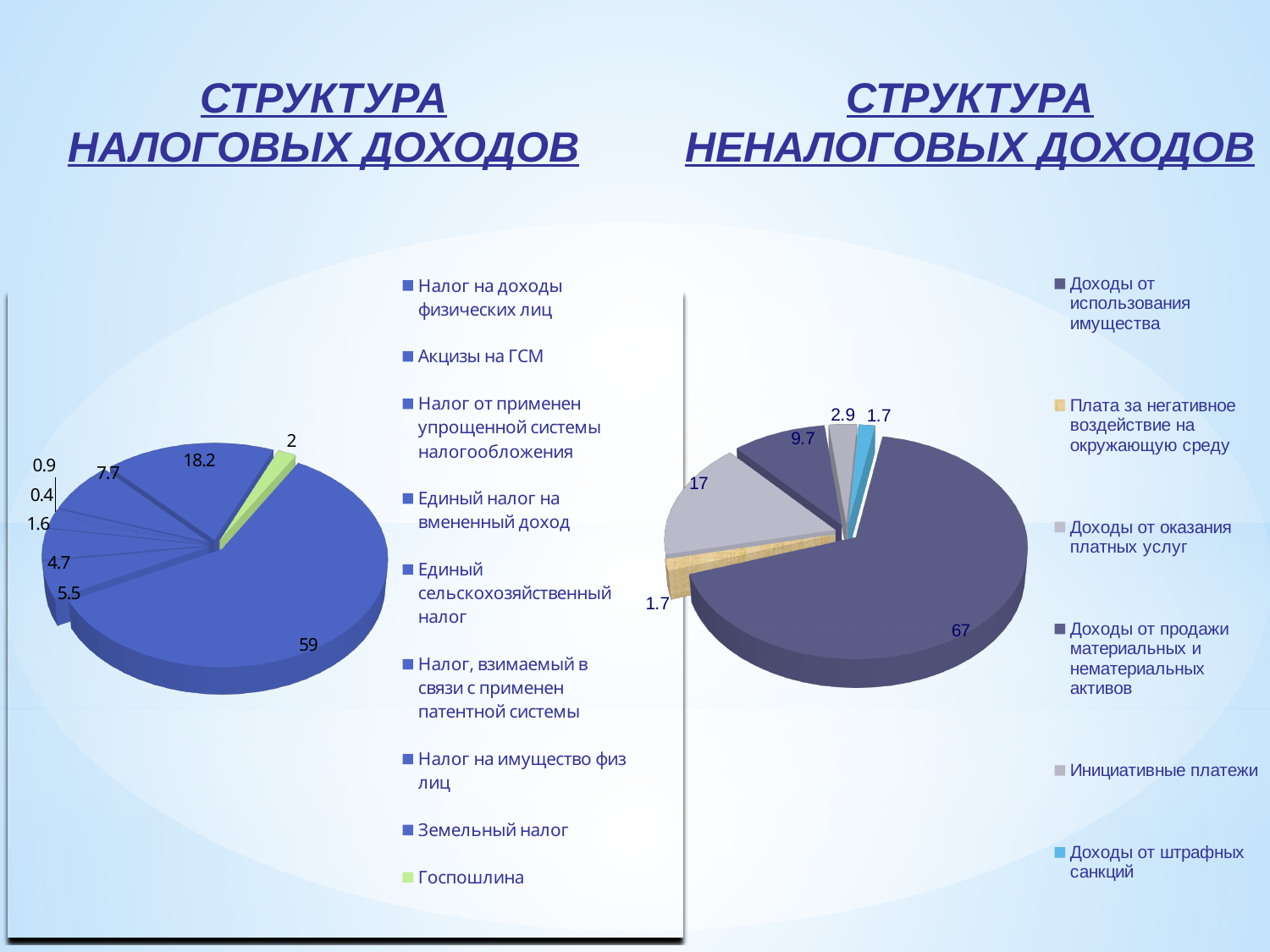
On the left chart 'СТРУКТУРА НАЛОГОВЫХ ДОХОДОВ', what is the largest value shown on a slice? 59 How many entries does the legend of the right chart 'СТРУКТУРА НЕНАЛОГОВЫХ ДОХОДОВ' list? 6 On the right chart 'СТРУКТУРА НЕНАЛОГОВЫХ ДОХОДОВ', what value is shown for 'Доходы от продажи материальных и нематериальных активов'? 9.7 On the left chart 'СТРУКТУРА НАЛОГОВЫХ ДОХОДОВ', what is the smallest value shown on a slice? 0.4 On the left chart 'СТРУКТУРА НАЛОГОВЫХ ДОХОДОВ', what is the difference between the slice labelled 18.2 and the slice labelled 7.7? 10.5 What type of chart is used on the left chart titled 'СТРУКТУРА НАЛОГОВЫХ ДОХОДОВ'? Pie chart On the right chart 'СТРУКТУРА НЕНАЛОГОВЫХ ДОХОДОВ', which is larger: 'Доходы от оказания платных услуг' or 'Доходы от продажи материальных и нематериальных активов'? Доходы от оказания платных услуг On the right chart 'СТРУКТУРА НЕНАЛОГОВЫХ ДОХОДОВ', what value is shown for 'Доходы от оказания платных услуг'? 17 On the left chart 'СТРУКТУРА НАЛОГОВЫХ ДОХОДОВ', what value is shown for the green slice (Госпошлина)? 2 On the right chart 'СТРУКТУРА НЕНАЛОГОВЫХ ДОХОДОВ', which category has the largest share? Доходы от использования имущества On the right chart 'СТРУКТУРА НЕНАЛОГОВЫХ ДОХОДОВ', what value is shown for 'Доходы от использования имущества'? 67 How many entries does the legend of the left chart 'СТРУКТУРА НАЛОГОВЫХ ДОХОДОВ' list? 9